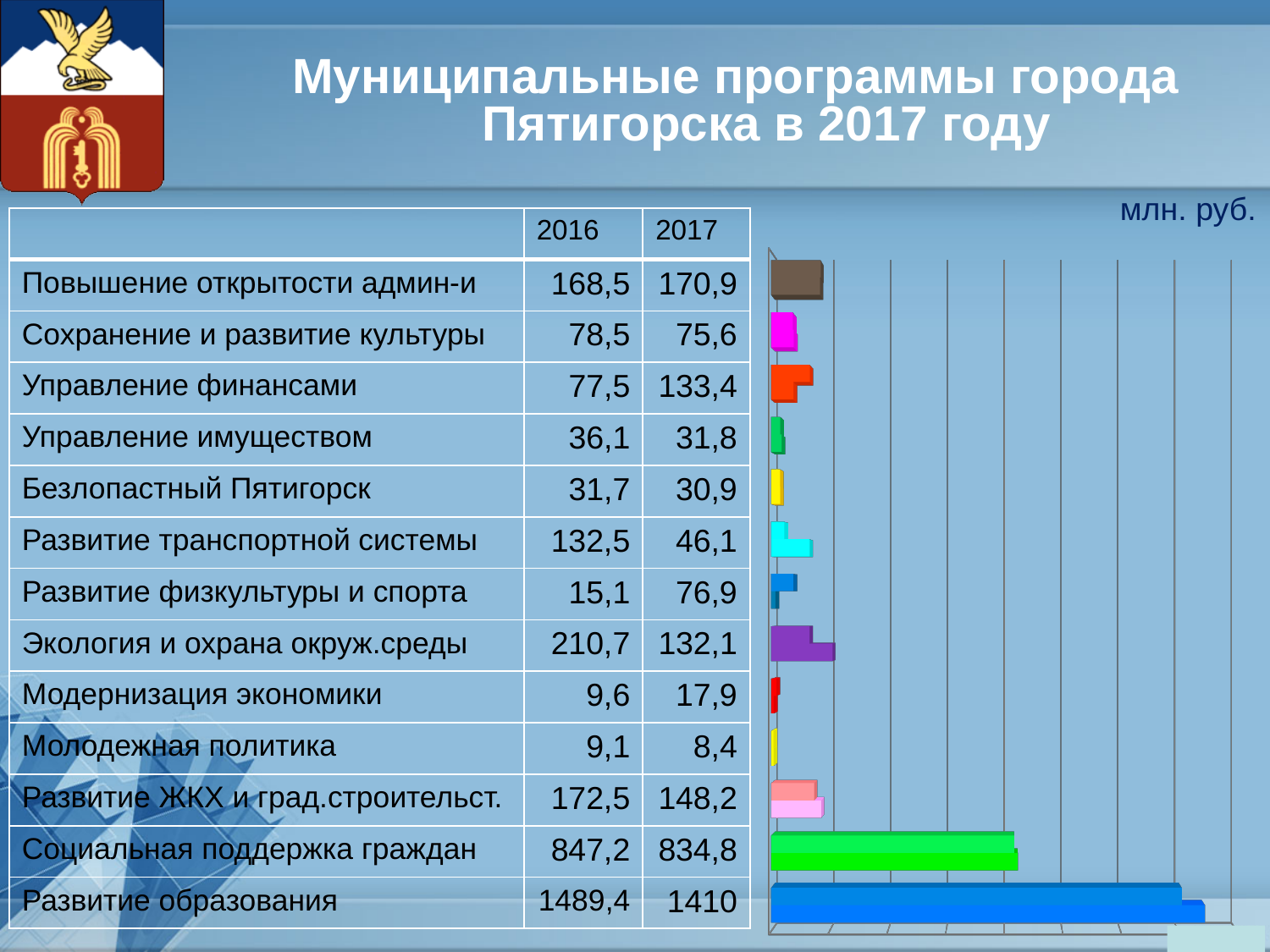
What kind of chart is shown on the slide? bar chart Which program has the highest value in 2017? Развитие образования Which program has the lowest value in 2017? Молодежная политика Which is larger: the 2017 value for Социальная поддержка граждан or the 2017 value for Развитие ЖКХ и град.строительст.? Социальная поддержка граждан Which is larger for Развитие транспортной системы: the 2016 value or the 2017 value? 2016 What is the 2016 value for Социальная поддержка граждан? 847,2 What is the difference between the 2016 and 2017 values for Развитие физкультуры и спорта? 61,8 What is the 2017 value for Развитие образования? 1410 What is the difference between the 2016 and 2017 values for Экология и охрана окруж.среды? 78,6 What is the 2017 value for Управление финансами? 133,4 How many program categories are plotted in the chart? 13 What unit is indicated above the chart? млн. руб.